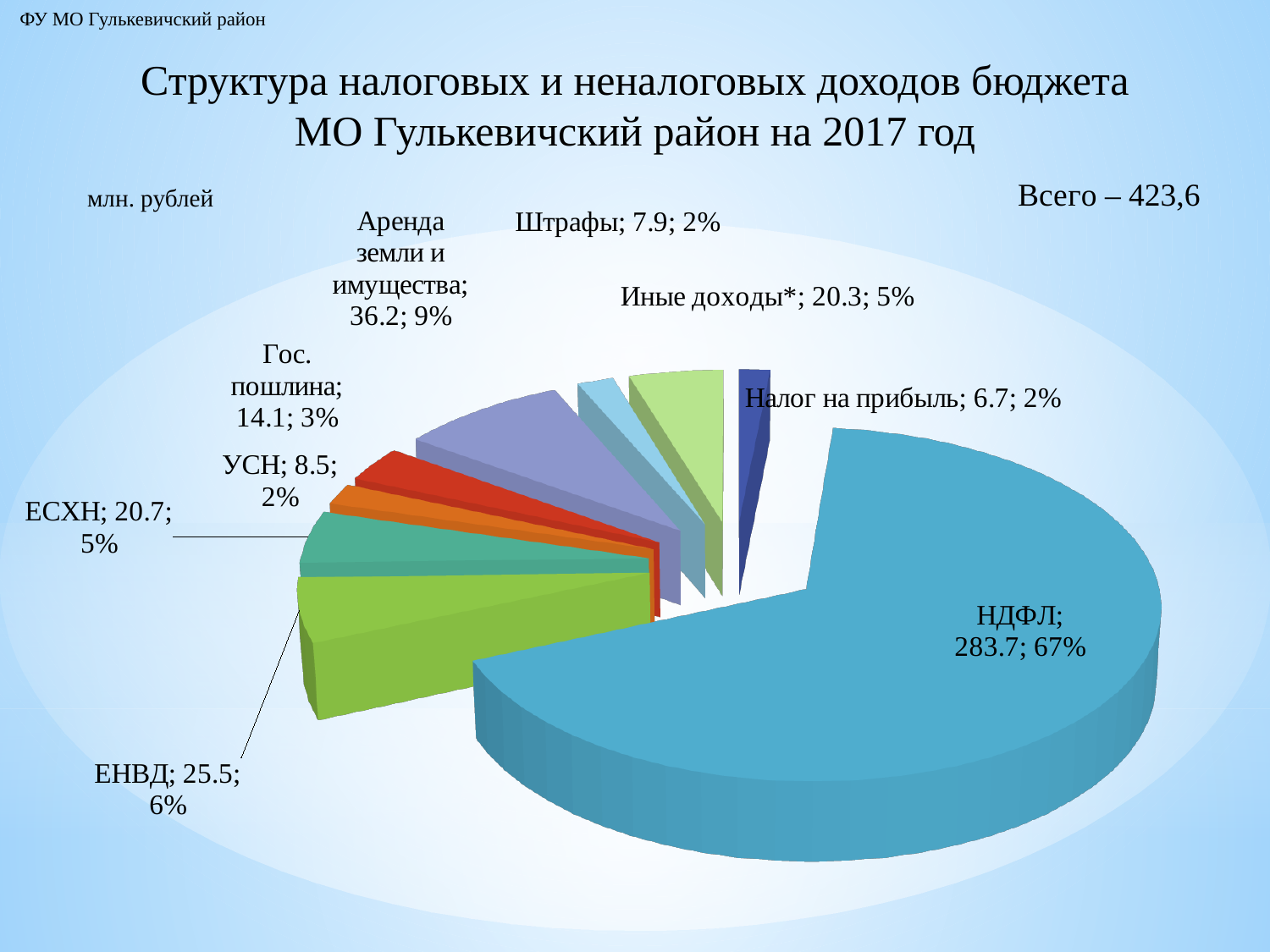
What is the value for Аренда земли и имущества? 36.2 What kind of chart is shown on the slide? pie chart Which category has the largest value? НДФЛ Which category has the smallest value? Налог на прибыль What share of the pie does ЕНВД represent? 6% What is the value for Налог на прибыль? 6.7 How many categories are shown in the pie chart? 9 What is the value for НДФЛ? 283.7 What share of the pie does НДФЛ represent? 67% Which is larger, the value for Гос. пошлина or the value for УСН? Гос. пошлина What is the difference between the values for ЕНВД and ЕСХН? 4.8 What total is stated on the slide for the chart? 423,6